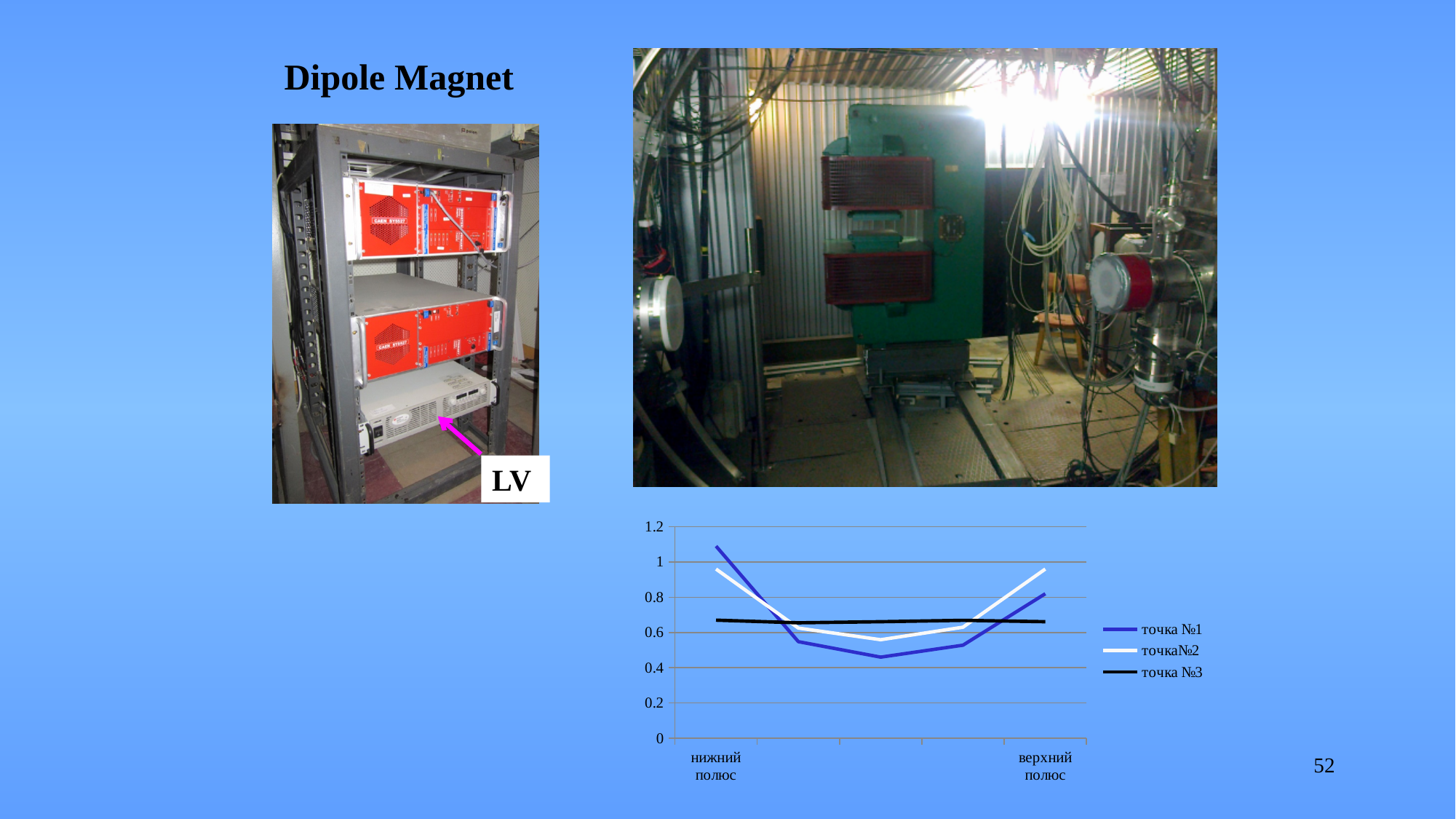
Which series has the highest value at нижний полюс? точка №1 At нижний полюс, which series has the larger value: точка №1 or точка №3? точка №1 What kind of chart is shown at the bottom right of the slide? line chart At верхний полюс, which series has the larger value: точка№2 or точка №1? точка№2 What is the highest value shown on the y axis of the line chart? 1.2 What colour is the line for точка №3 in the chart? black Is the value for точка №1 at верхний полюс greater or less than 1? less Is the value for точка№2 at верхний полюс greater or less than 0.8? greater What are the legend entries of the line chart? точка №1, точка№2, точка №3 How many series does the legend of the line chart list? 3 Is the value for точка №3 at нижний полюс greater or less than 0.8? less